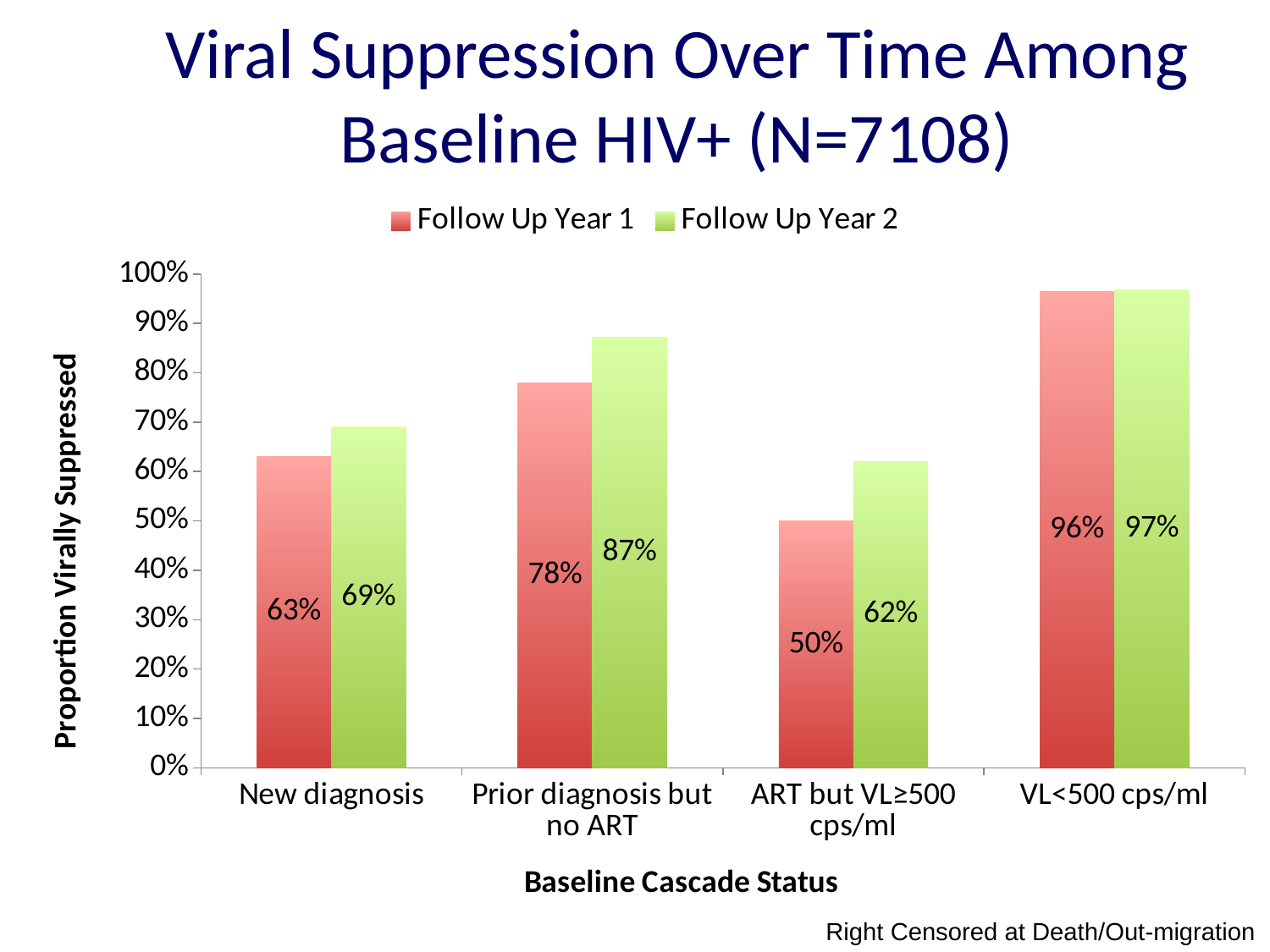
What is the Follow Up Year 1 value for New diagnosis? 63% What is the Follow Up Year 2 value for Prior diagnosis but no ART? 87% What is the Follow Up Year 1 value for ART but VL≥500 cps/ml? 50% Which category has the highest Follow Up Year 1 value? VL<500 cps/ml Which is larger for Prior diagnosis but no ART: the Follow Up Year 1 value or the Follow Up Year 2 value? Follow Up Year 2 What is the Follow Up Year 2 value for VL<500 cps/ml? 97% What is the label of the y axis? Proportion Virally Suppressed How many series does the legend list? 2 What is the difference between the Follow Up Year 2 and Follow Up Year 1 values for ART but VL≥500 cps/ml? 12% What kind of chart is shown on the slide? Bar chart Which category has the lowest Follow Up Year 2 value? ART but VL≥500 cps/ml How many categories are shown on the x axis? 4